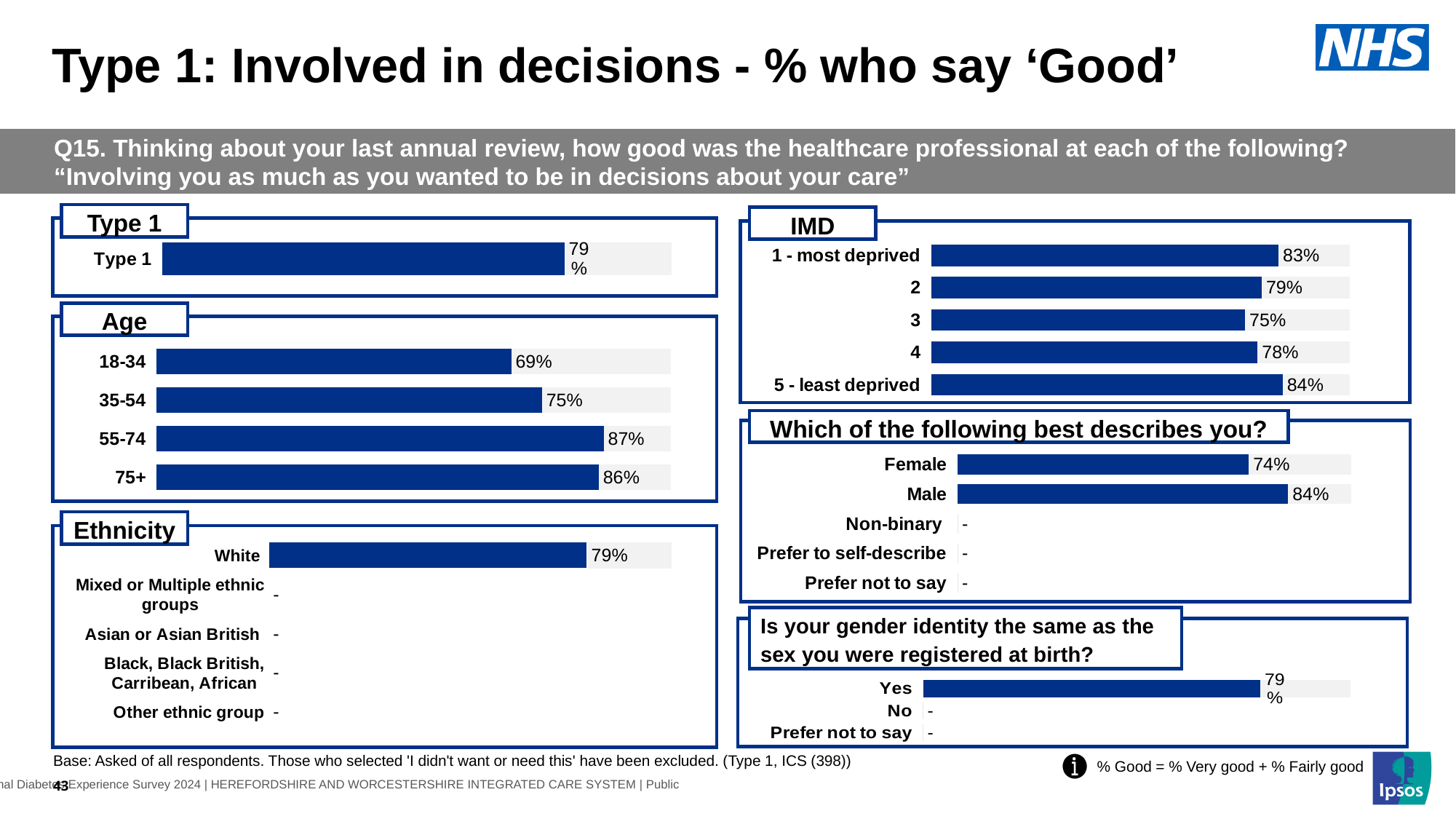
In the Age chart, what is the difference between the 55-74 and 18-34 values? 18 percentage points In the IMD chart, which category has the highest value? 5 - least deprived In the IMD chart, what is the value for '1 - most deprived'? 83% In the Age chart, what is the value for the 55-74 age group? 87% In the Ethnicity chart, what is the value for White? 79% In the 'Is your gender identity the same as the sex you were registered at birth?' chart, what is the value for Yes? 79% In the 'Which of the following best describes you?' chart, which is larger, Female or Male? Male In the IMD chart, how many categories are shown? 5 In the Age chart, which age group has the lowest value? 18-34 In the 'Which of the following best describes you?' chart, what is the difference between the Male and Female values? 10 percentage points In the IMD chart, which category has the lowest value? 3 What type of chart is used in the Age section? Bar chart